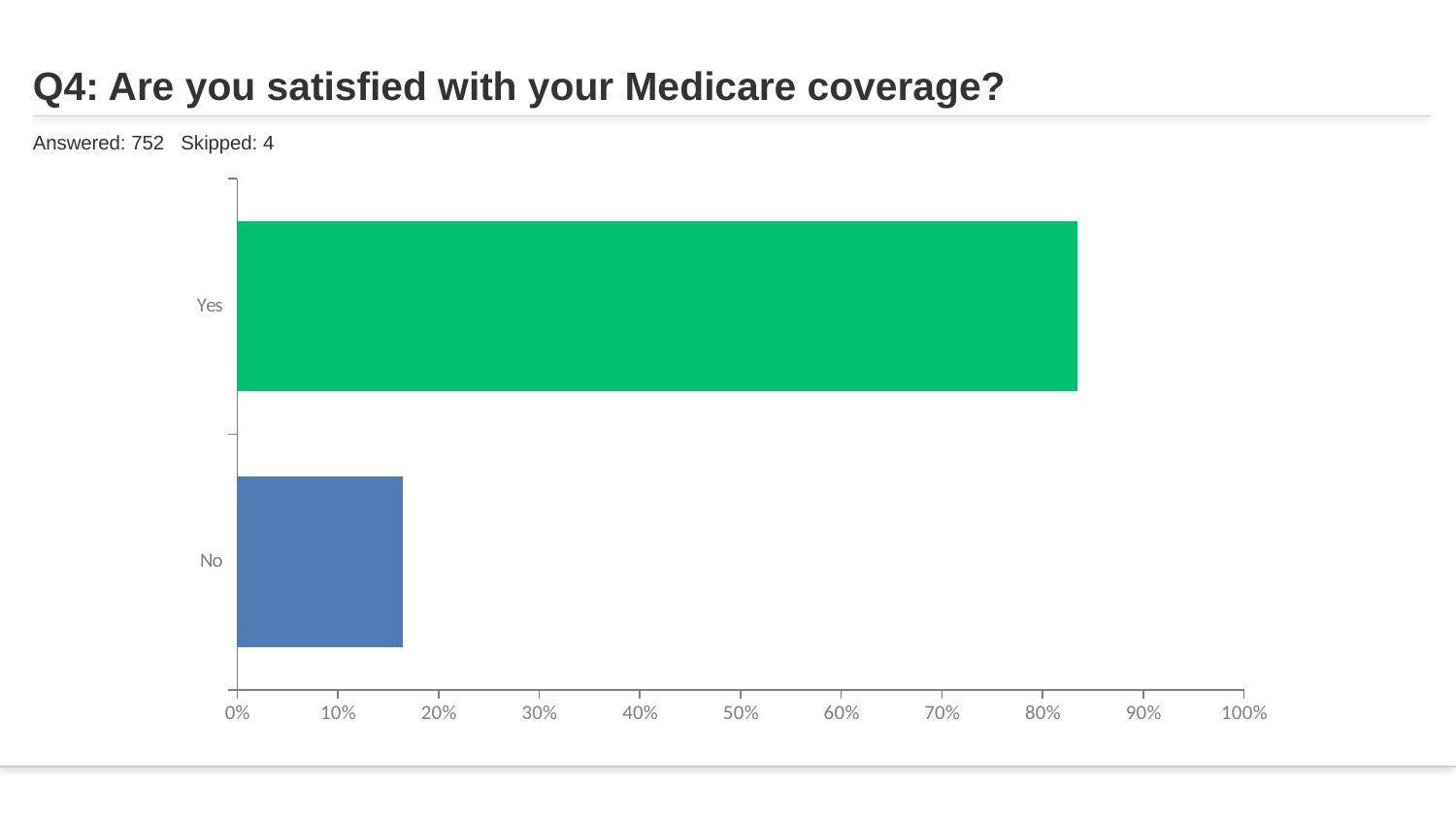
Is the value for Yes greater or less than 80%? greater Is the value for Yes greater or less than 50%? greater What kind of chart is shown on the slide? bar chart Is the value for No greater or less than 10%? greater Which category has the highest value? Yes What is the title of the chart? Q4: Are you satisfied with your Medicare coverage? How many respondents answered the question according to the slide? 752 How many categories are plotted in the chart? 2 Which category has the lowest value? No Which is larger, the value for Yes or the value for No? Yes